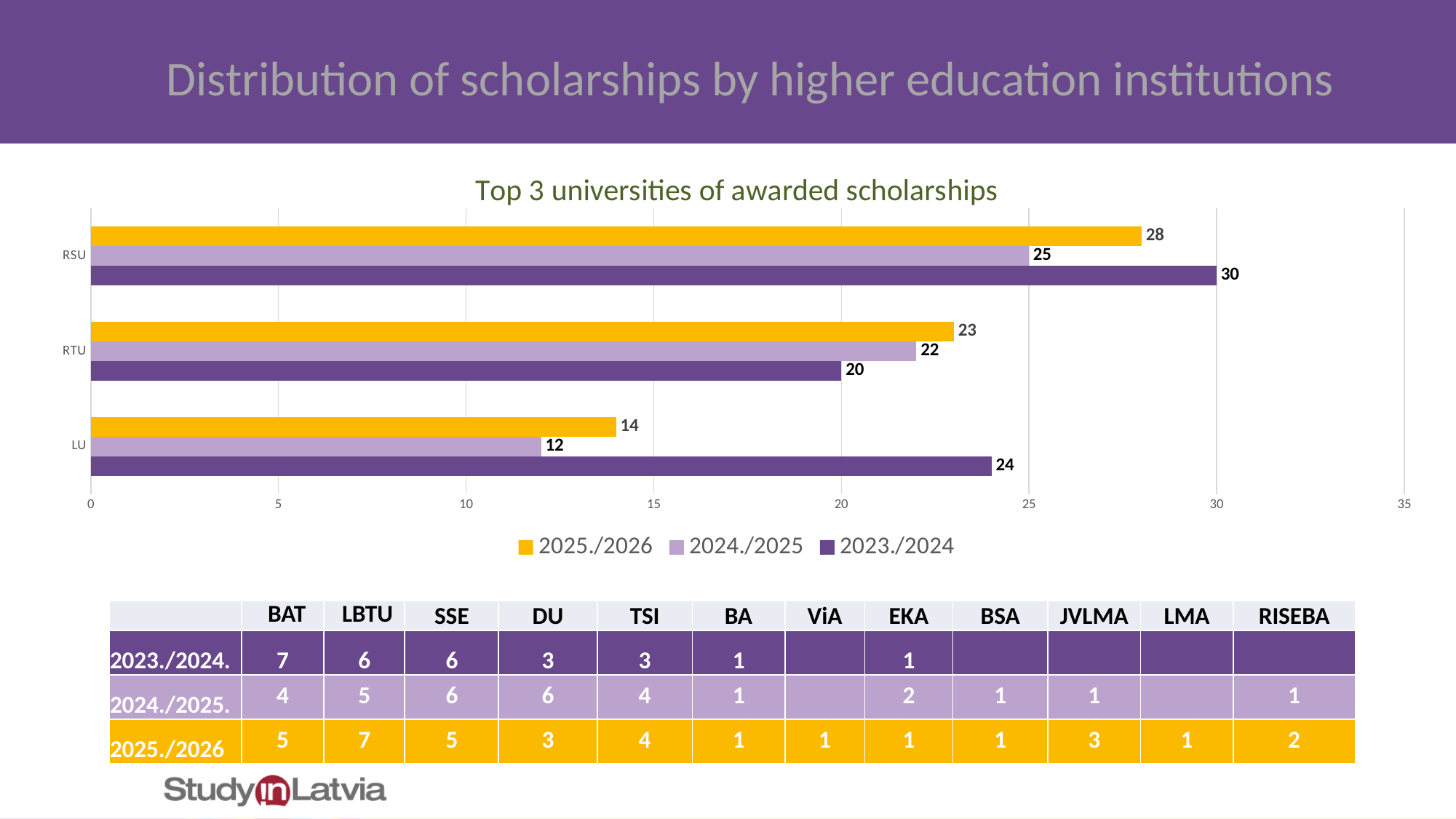
Which university has the highest value in the 2025./2026 series? RSU Which is larger for RTU: the 2023./2024 value or the 2024./2025 value? 2024./2025 What kind of chart is shown on the slide? bar chart What is the title of the chart? Top 3 universities of awarded scholarships How many series does the legend list? 3 What is the value for RSU in the 2023./2024 series? 30 What is the value for LU in the 2024./2025 series? 12 Is the value for RSU in the 2024./2025 series greater or less than 20? greater What is the value for RTU in the 2025./2026 series? 23 What is the difference between the 2023./2024 and 2025./2026 values for LU? 10 Which university has the lowest value in the 2024./2025 series? LU How many universities are shown on the chart? 3